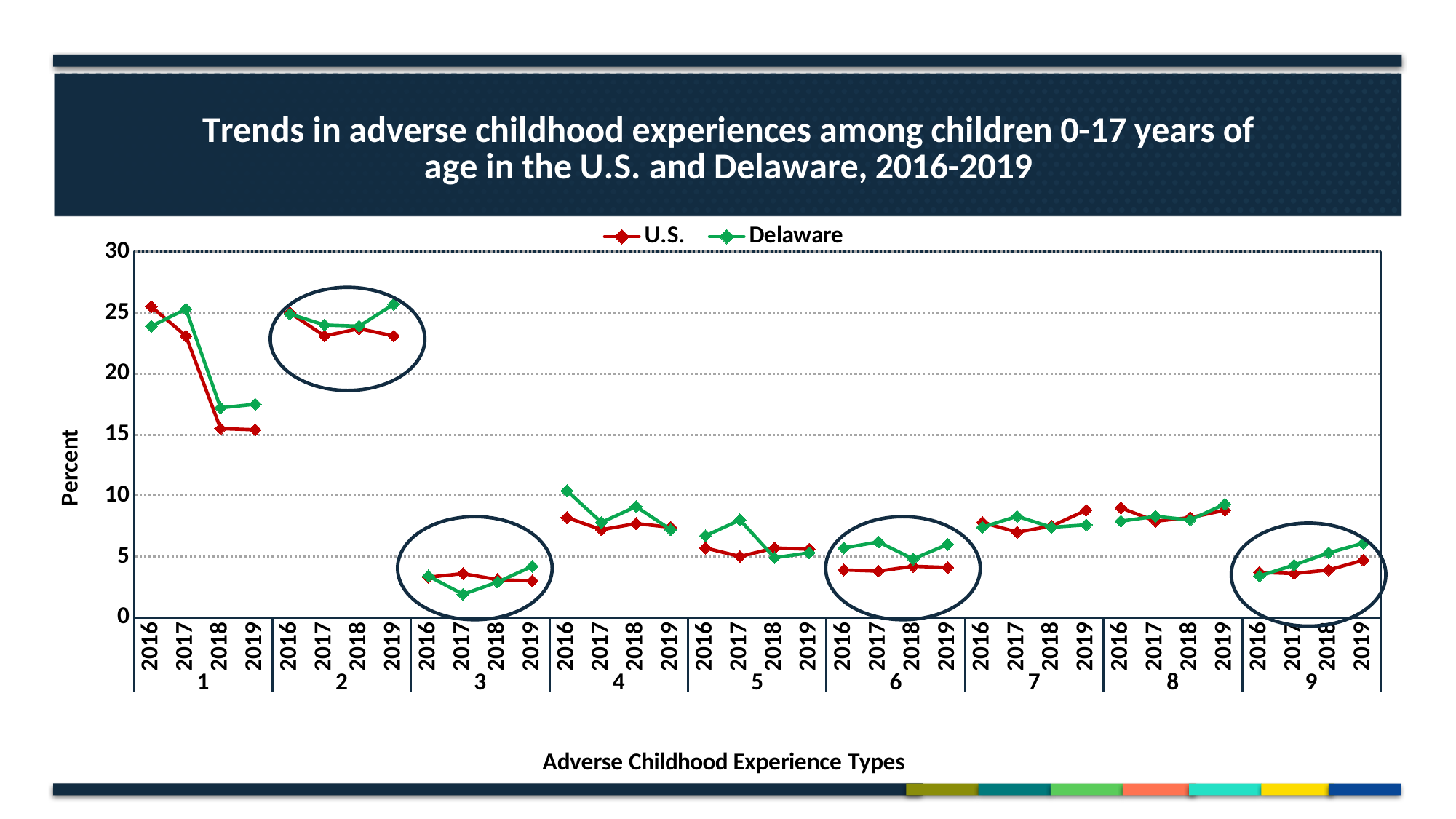
How many adverse childhood experience types are shown along the x axis? 9 How many years are plotted for each adverse childhood experience type? 4 What kind of chart is shown on the slide? Line chart How many series does the legend list? 2 Do the U.S. values for adverse childhood experience type 1 rise or fall from 2016 to 2019? Fall For 2016 in adverse childhood experience type 6, which series has the higher value, U.S. or Delaware? Delaware Is the U.S. value for 2017 in adverse childhood experience type 2 greater or less than 25? less Is the Delaware value for 2017 in adverse childhood experience type 3 greater or less than 5? less Is the Delaware value for 2018 in adverse childhood experience type 1 greater or less than 15? greater For 2017 in adverse childhood experience type 3, which series has the higher value, U.S. or Delaware? U.S. What are the two series named in the legend? U.S. and Delaware What is the label of the y axis? Percent